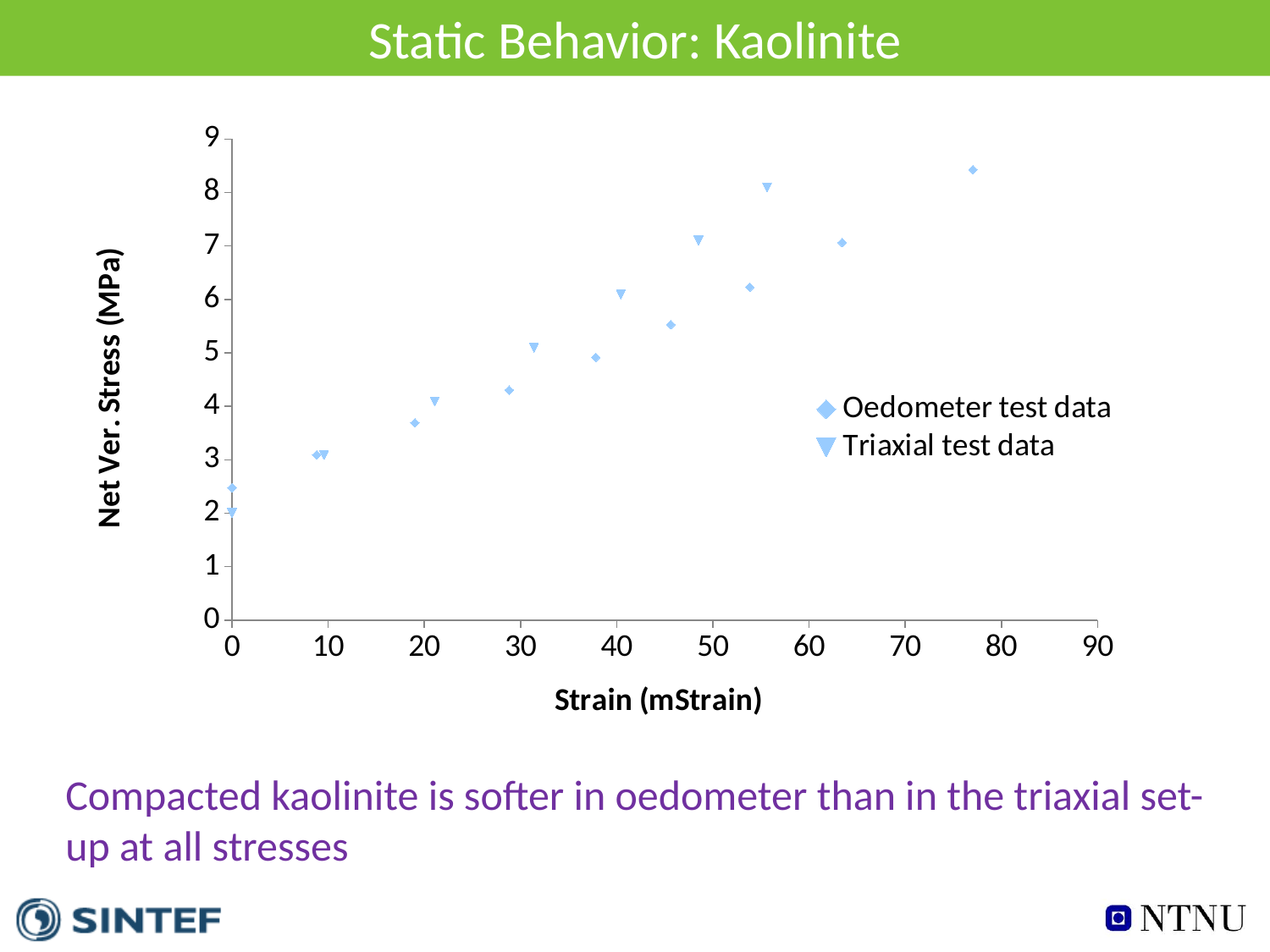
Is the Oedometer test data point near 29 mStrain greater or less than 4 MPa? greater What is the title of the y axis? Net Ver. Stress (MPa) Is the Triaxial test data point at 0 strain greater or less than 3 MPa? less How many series does the legend list? 2 Does the net vertical stress rise or fall as strain increases for the Triaxial test data? Rise What kind of chart is shown on the slide? Scatter chart At 0 strain, which series has the higher net vertical stress? Oedometer test data What are the two series named in the legend? Oedometer test data and Triaxial test data Is the Oedometer test data point near 54 mStrain greater or less than 6 MPa? greater Does the net vertical stress rise or fall as strain increases for the Oedometer test data? Rise Which series reaches the larger strain value? Oedometer test data